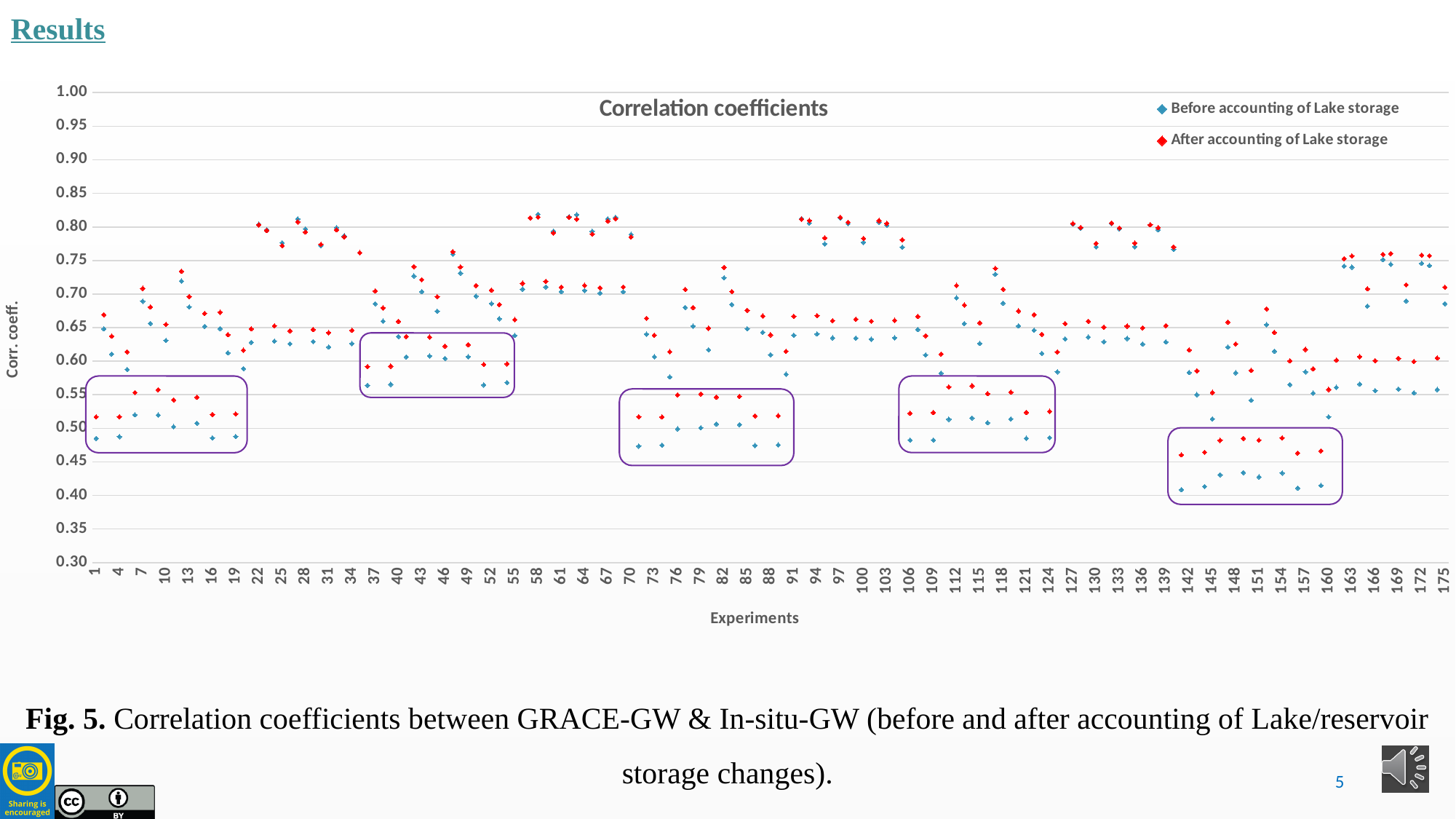
How many series does the legend list? 2 Is the value for 'Before accounting of Lake storage' at experiment 73 greater or less than 0.50? greater What kind of chart is shown on the slide? Scatter chart At experiment 1, which series has the higher value: 'Before accounting of Lake storage' or 'After accounting of Lake storage'? After accounting of Lake storage Is the value for 'Before accounting of Lake storage' at experiment 1 greater or less than 0.50? less Is the value for 'After accounting of Lake storage' at experiment 58 greater or less than 0.80? greater Which colour represents the 'After accounting of Lake storage' series? Red At experiment 142, which series has the higher value: 'Before accounting of Lake storage' or 'After accounting of Lake storage'? After accounting of Lake storage What is the title of the chart? Correlation coefficients